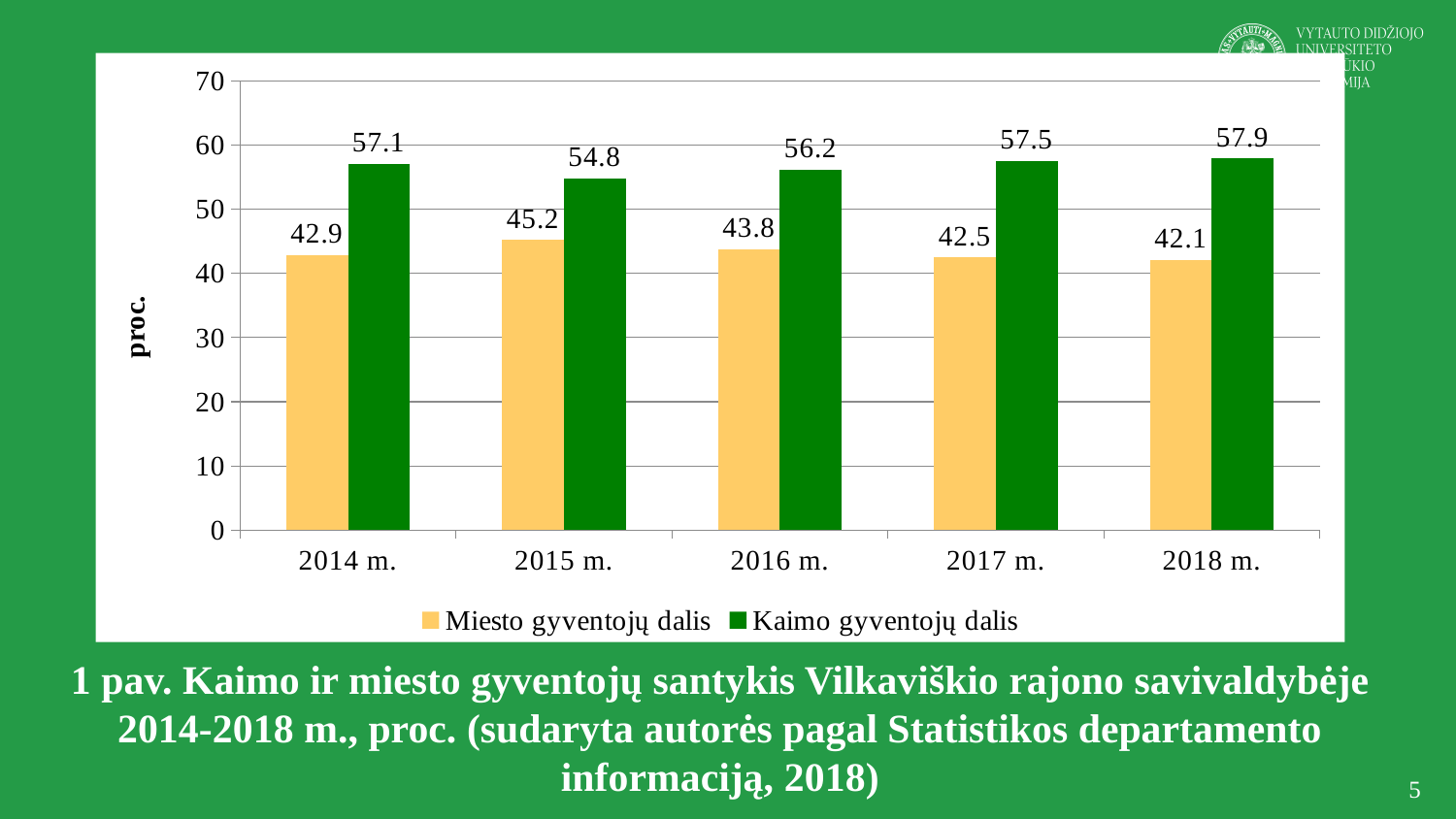
In which year is Kaimo gyventojų dalis lowest? 2015 m. What kind of chart is shown on the slide? bar chart How many years are shown on the x axis? 5 How many series does the legend list? 2 What is the value for Kaimo gyventojų dalis in 2018 m.? 57.9 What is the value for Miesto gyventojų dalis in 2014 m.? 42.9 In which year is Miesto gyventojų dalis highest? 2015 m. Which is larger in 2016 m., Miesto gyventojų dalis or Kaimo gyventojų dalis? Kaimo gyventojų dalis What is the value for Kaimo gyventojų dalis in 2015 m.? 54.8 What is the difference between Kaimo gyventojų dalis and Miesto gyventojų dalis in 2017 m.? 15 Is the value for Kaimo gyventojų dalis in 2014 m. greater or less than 50? greater What is the label of the y axis? proc.